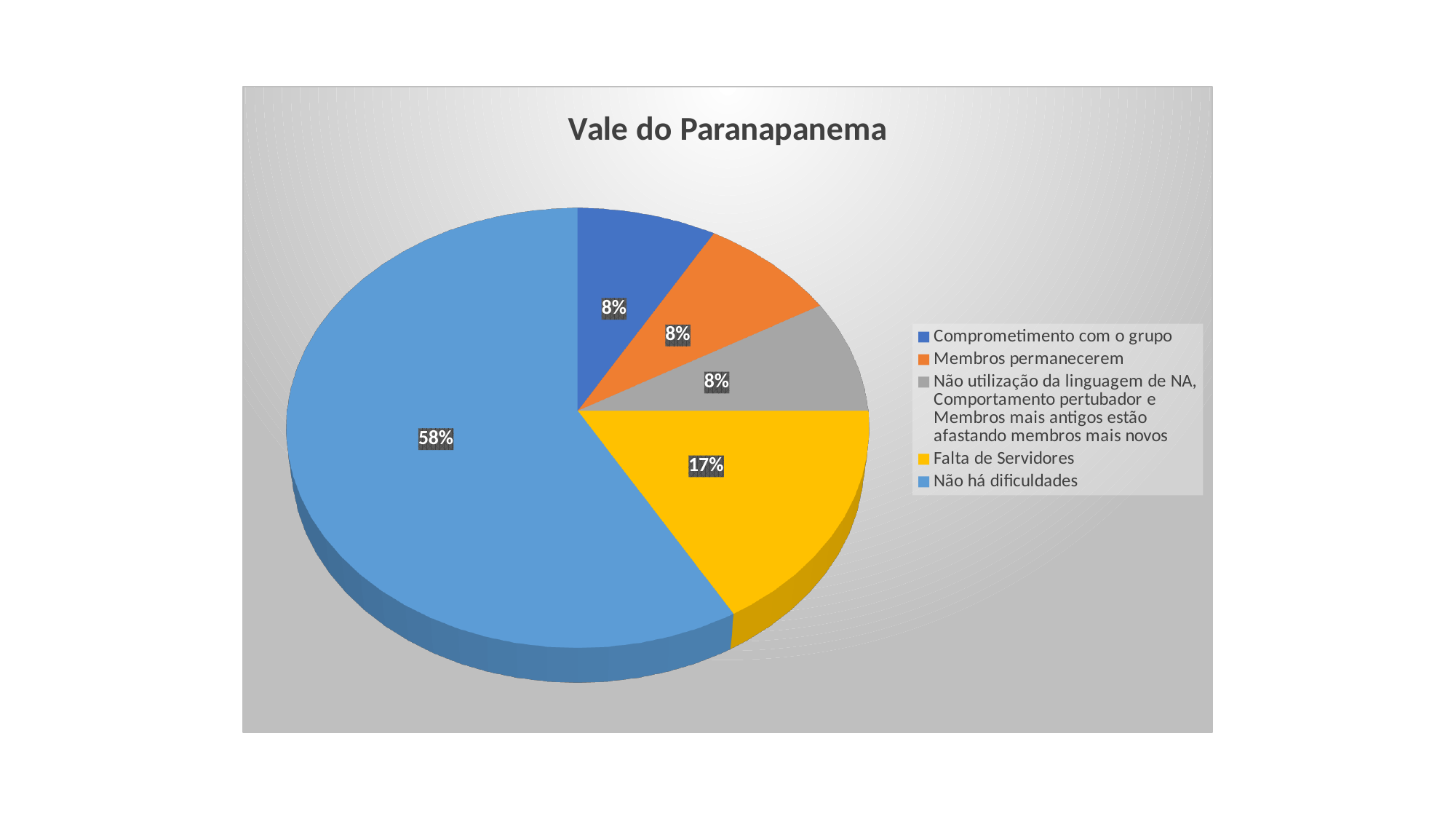
Which is larger: the share for 'Falta de Servidores' or the share for 'Membros permanecerem'? Falta de Servidores What colour is the slice for 'Falta de Servidores'? yellow What share of the pie is 'Falta de Servidores'? 17% How many slices does the pie chart have? 5 What share of the pie is 'Membros permanecerem'? 8% How many entries does the legend list? 5 What share of the pie is 'Não há dificuldades'? 58% What is the title of the chart? Vale do Paranapanema Which category has the largest slice of the pie? Não há dificuldades What kind of chart is shown on the slide? pie chart What is the difference between the shares of 'Não há dificuldades' and 'Falta de Servidores'? 41%